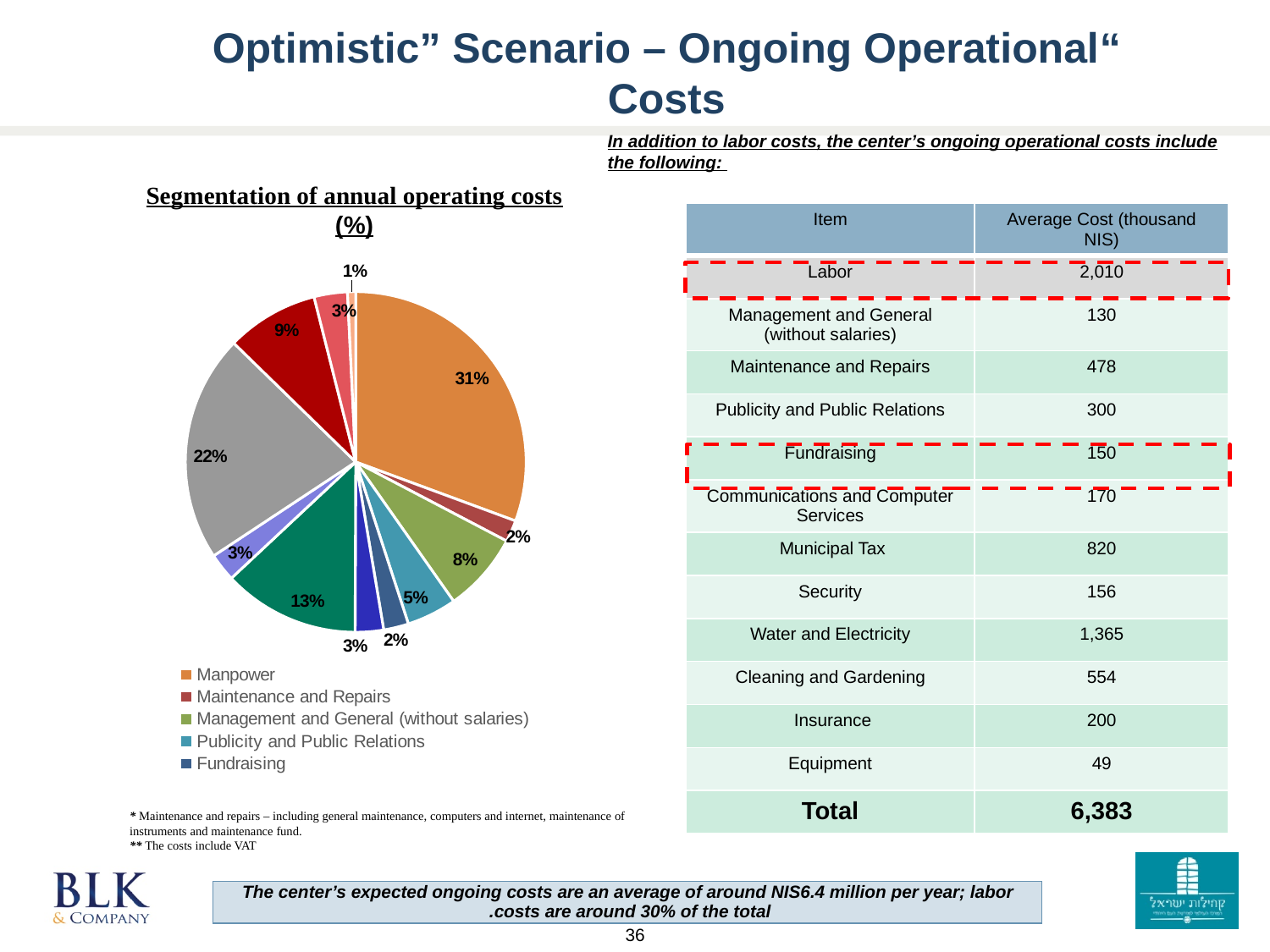
What share of annual operating costs does Manpower account for in the pie chart? 31% What is the percentage of the smallest slice in the pie chart? 1% What share of annual operating costs does Publicity and Public Relations account for in the pie chart? 5% What share of annual operating costs does Management and General (without salaries) account for in the pie chart? 8% What kind of chart is shown on the slide? pie chart What is the title of the pie chart? Segmentation of annual operating costs (%) By how many percentage points does the Manpower slice exceed the Management and General (without salaries) slice? 23 How many entries does the pie chart's legend list? 5 Which legend category has the largest slice in the pie chart? Manpower Which slice is larger in the pie chart, Manpower or Publicity and Public Relations? Manpower How many slices does the pie chart have? 12